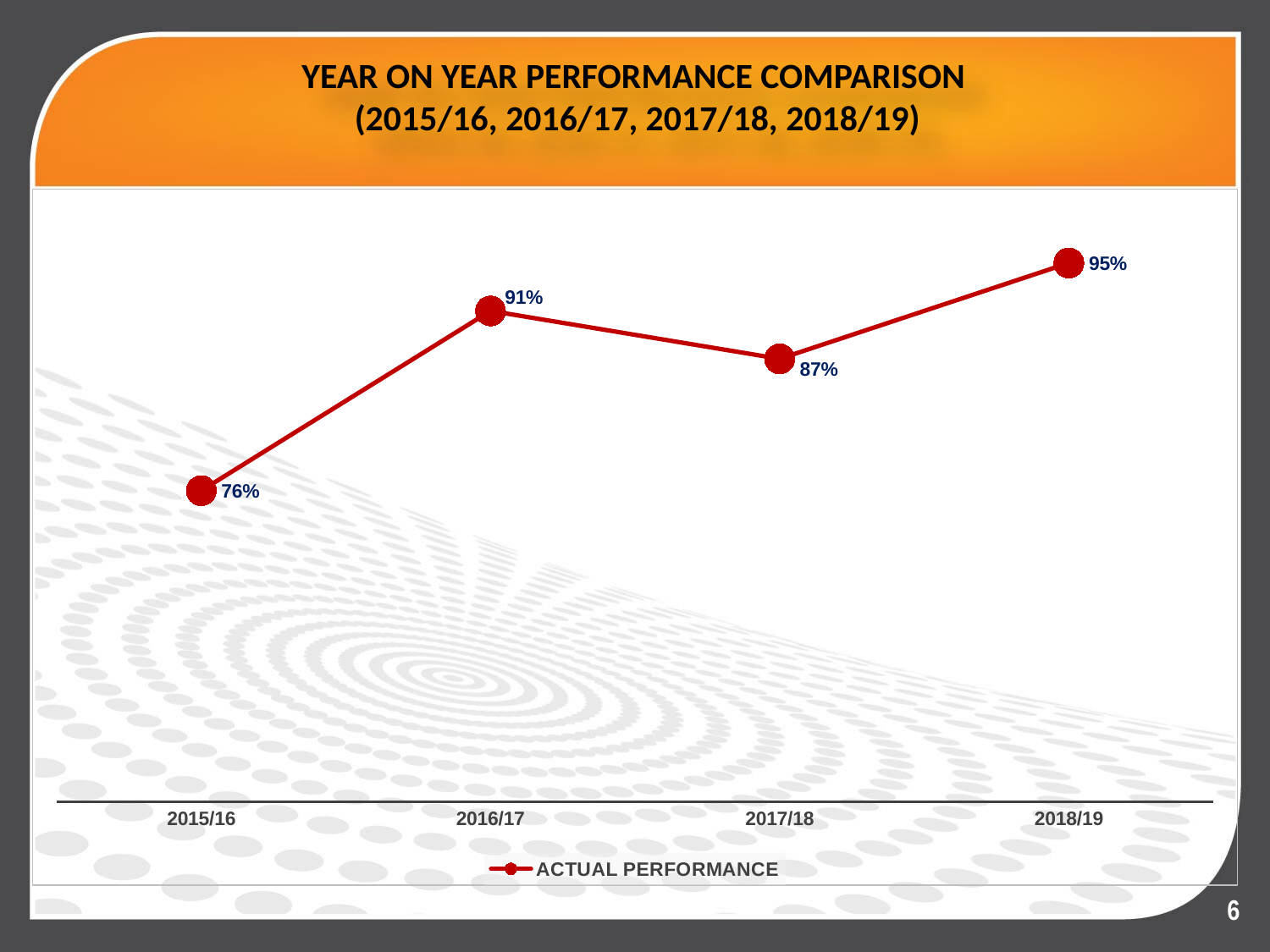
What is the actual performance value for 2018/19? 95% What is the name of the series shown in the legend? ACTUAL PERFORMANCE How many years are plotted on the chart? 4 What is the actual performance value for 2017/18? 87% Which year has the highest actual performance? 2018/19 Which year has the lowest actual performance? 2015/16 What is the actual performance value for 2015/16? 76% What is the difference in actual performance between 2018/19 and 2015/16? 19% What kind of chart is shown on the slide? Line chart What is the difference in actual performance between 2016/17 and 2017/18? 4% What is the actual performance value for 2016/17? 91% Which year has the higher actual performance, 2016/17 or 2017/18? 2016/17